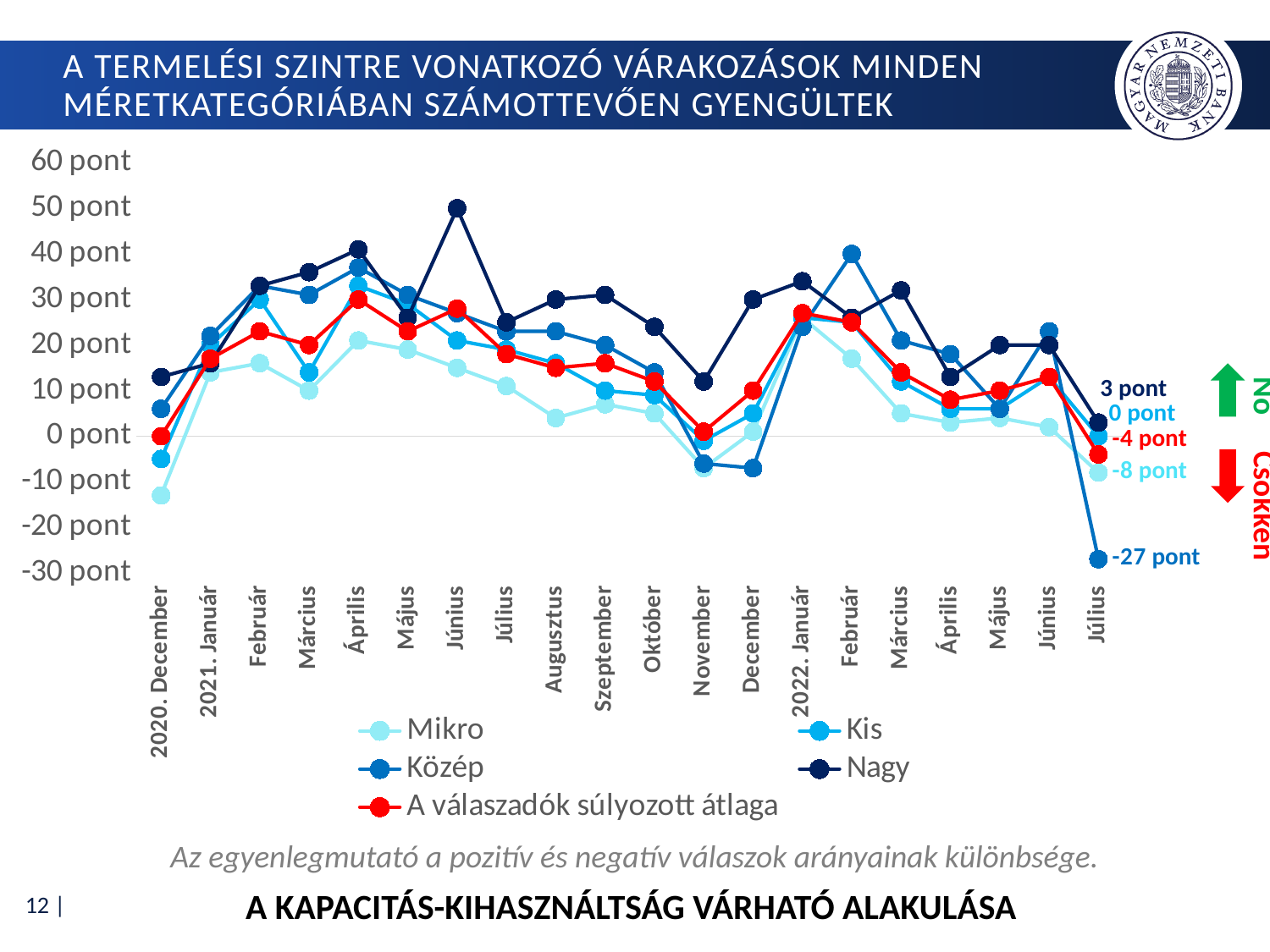
Which series has the highest value in 2022. Július? Nagy What kind of chart is shown on the slide? line chart What is the difference between the Nagy and Közép values in 2022. Július? 30 pont Is the value of the Nagy series in 2021. Június greater or less than 40 pont? greater Which series has the lowest value in 2022. Július? Közép What is the value of 'A válaszadók súlyozott átlaga' in 2022. Július? -4 pont What is the value of the Mikro series in 2022. Július? -8 pont How many series does the legend list? 5 What is the value of the Közép series in 2022. Július? -27 pont What is the value of the Nagy series in 2022. Július? 3 pont How many months are shown on the x axis? 20 What is the value of the Kis series in 2022. Július? 0 pont